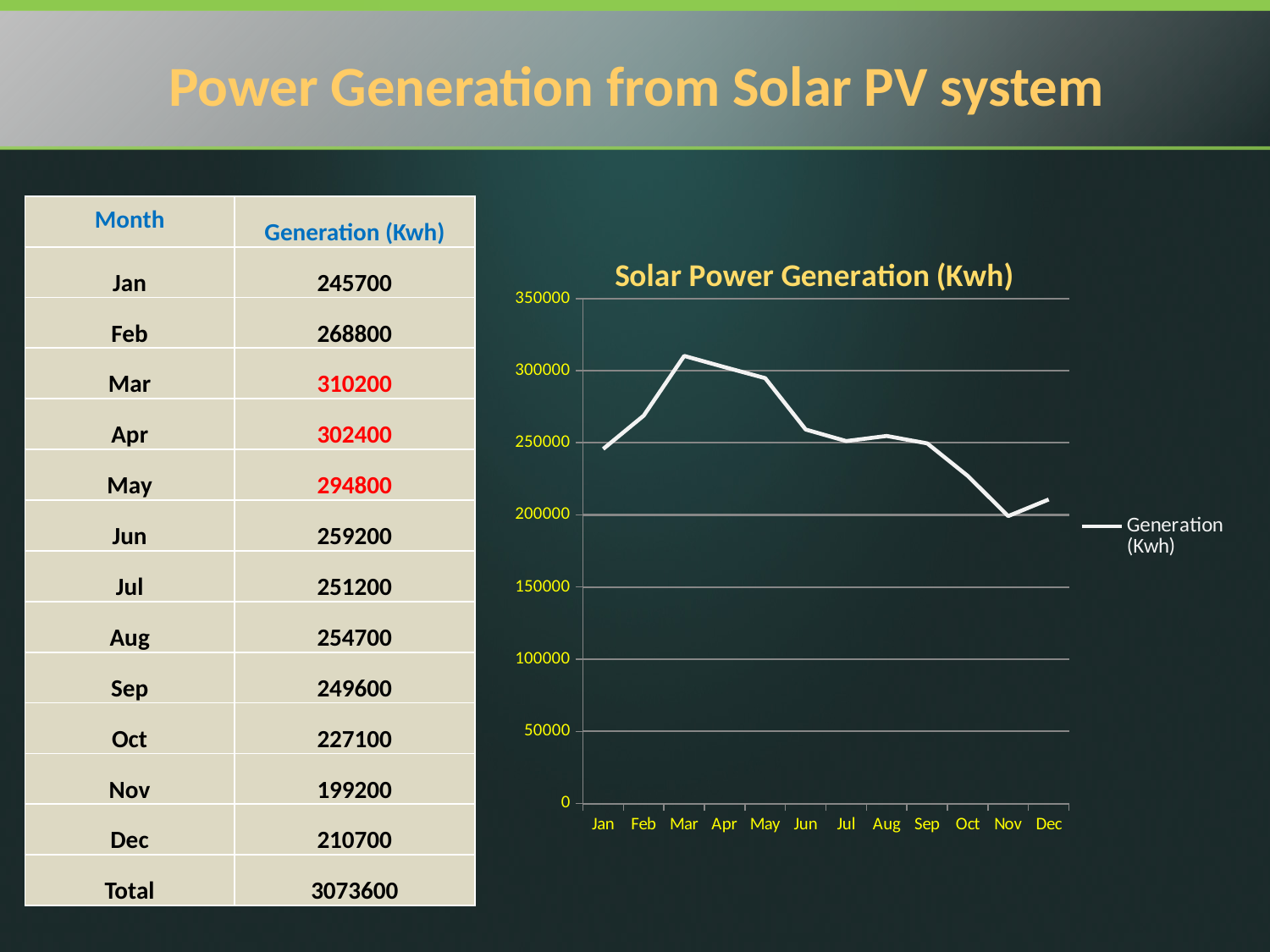
Which month has the lowest solar power generation? Nov Is the value for Oct greater or less than 250000? less Which month has the highest solar power generation? Mar What is the difference in generation between Mar and Nov? 111000 What is the generation value for Nov in Kwh? 199200 What is the title of the chart? Solar Power Generation (Kwh) Which month has higher generation, Feb or Jun? Feb What is the generation value for Mar in Kwh? 310200 Does the generation rise or fall from May to Nov? fall How many series does the chart legend list? 1 What type of chart is shown on the slide? line chart How many months are plotted along the x axis of the chart? 12